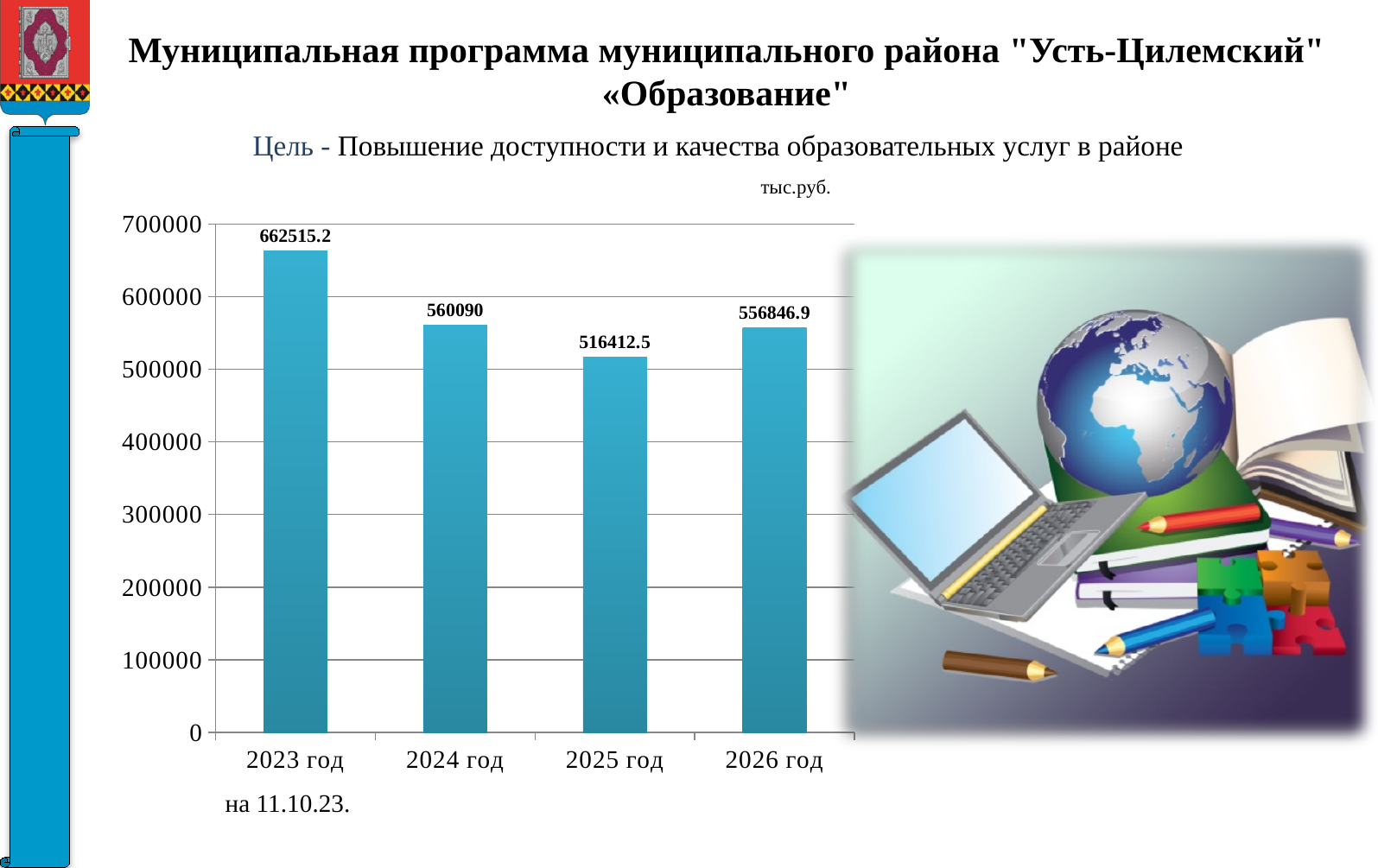
Is the value for 2025 год greater or less than 600000? less What is the value for 2025 год? 516412.5 What kind of chart is shown on the slide? bar chart What unit is indicated above the chart? тыс.руб. How many years are shown on the chart? 4 Which year has the highest value? 2023 год What is the difference between the values for 2023 год and 2024 год? 102425.2 Which year has the lowest value? 2025 год What is the value for 2026 год? 556846.9 Which is larger, the value for 2024 год or the value for 2026 год? 2024 год What is the difference between the values for 2026 год and 2025 год? 40434.4 What is the value for 2023 год? 662515.2